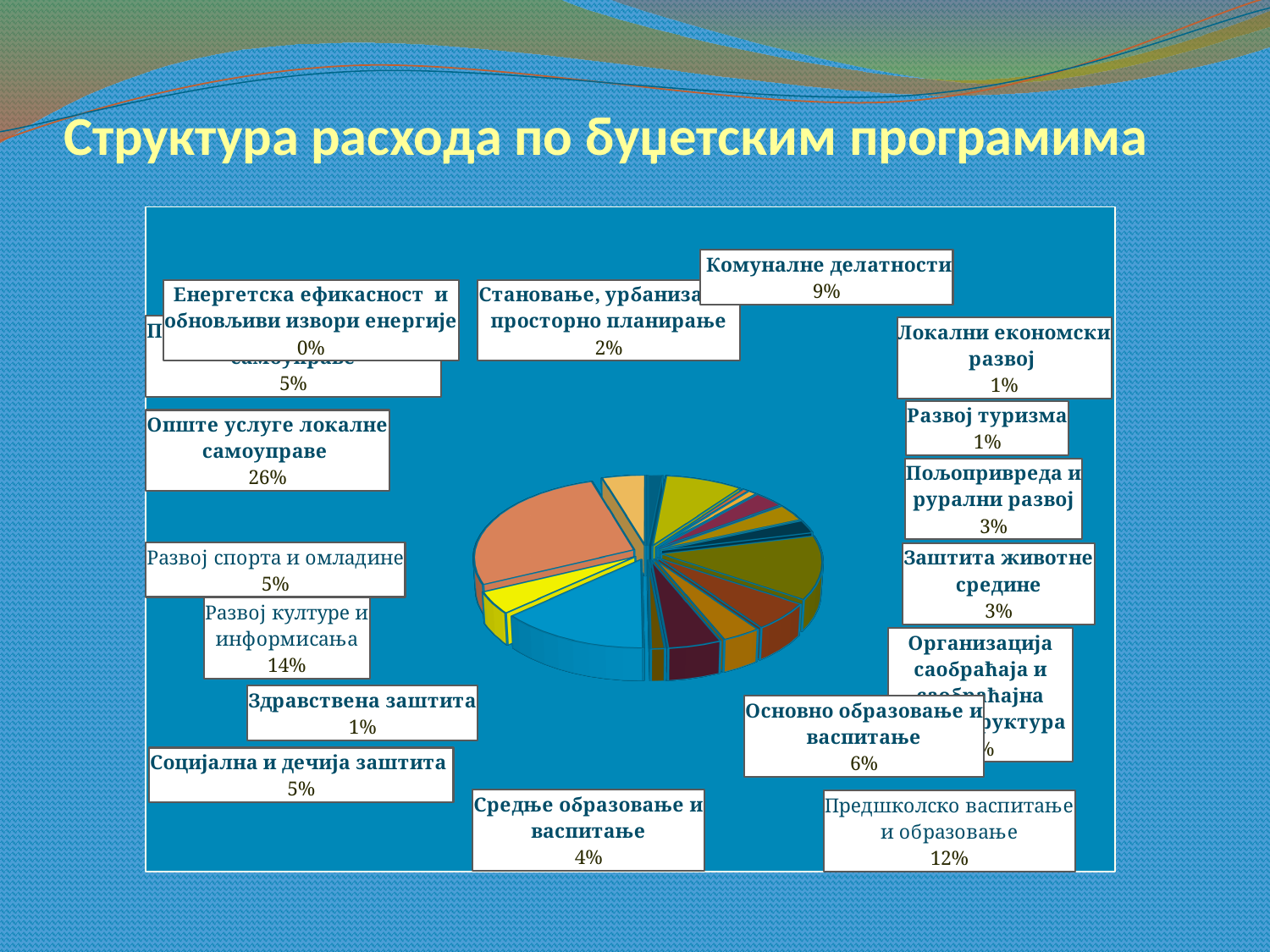
Which category has the largest share of the pie? Опште услуге локалне самоуправе What is the value shown for Предшколско васпитање и образовање? 12% Which category has the smallest share of the pie? Енергетска ефикасност и обновљиви извори енергије What is the value shown for Комуналне делатности? 9% What share of the pie does Опште услуге локалне самоуправе have? 26% What is the difference between the shares of Опште услуге локалне самоуправе and Развој културе и информисања? 12% What is the title of the slide? Структура расхода по буџетским програмима What is the value shown for Развој културе и информисања? 14% What kind of chart is shown on the slide? pie chart What is the value shown for Пољопривреда и рурални развој? 3% What is the value shown for Здравствена заштита? 1% Which is larger, the share for Основно образовање и васпитање or the share for Средње образовање и васпитање? Основно образовање и васпитање